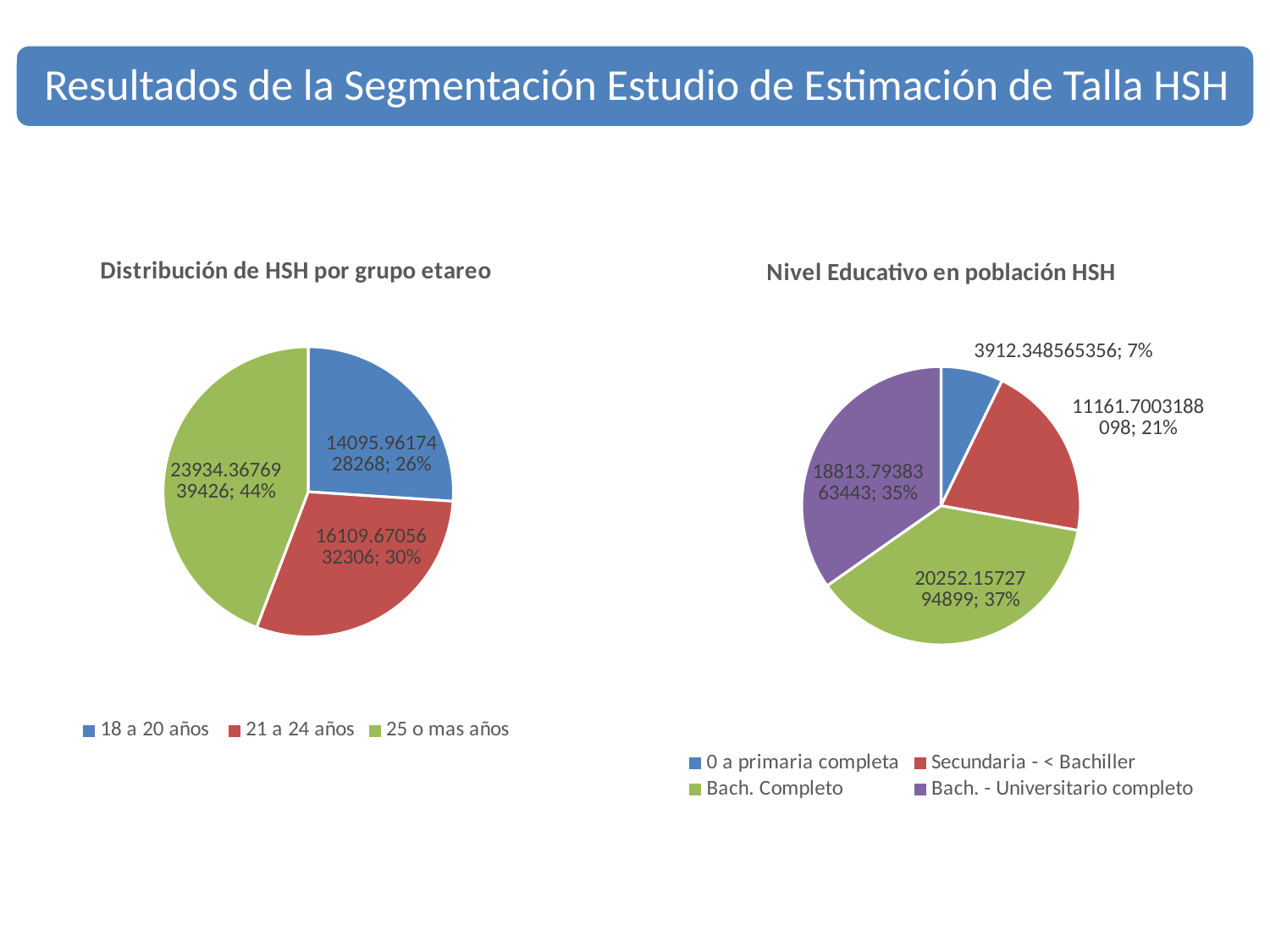
In the chart titled 'Distribución de HSH por grupo etareo', what share of the pie does the '18 a 20 años' slice represent? 26% In the chart titled 'Nivel Educativo en población HSH', what colour is the 'Bach. - Universitario completo' slice? Purple In the chart titled 'Distribución de HSH por grupo etareo', what share of the pie does the '25 o mas años' slice represent? 44% In the chart titled 'Nivel Educativo en población HSH', which education level has the smallest slice? 0 a primaria completa In the chart titled 'Nivel Educativo en población HSH', how many entries does the legend list? 4 In the chart titled 'Nivel Educativo en población HSH', which is larger: the 'Secundaria - < Bachiller' slice or the 'Bach. - Universitario completo' slice? Bach. - Universitario completo In the chart titled 'Nivel Educativo en población HSH', what share of the pie does the '0 a primaria completa' slice represent? 7% In the chart titled 'Distribución de HSH por grupo etareo', how many slices does the pie have? 3 In the chart titled 'Distribución de HSH por grupo etareo', which age group has the smallest slice? 18 a 20 años In the chart titled 'Distribución de HSH por grupo etareo', which age group has the largest slice? 25 o mas años What kind of chart is the chart titled 'Nivel Educativo en población HSH'? Pie chart